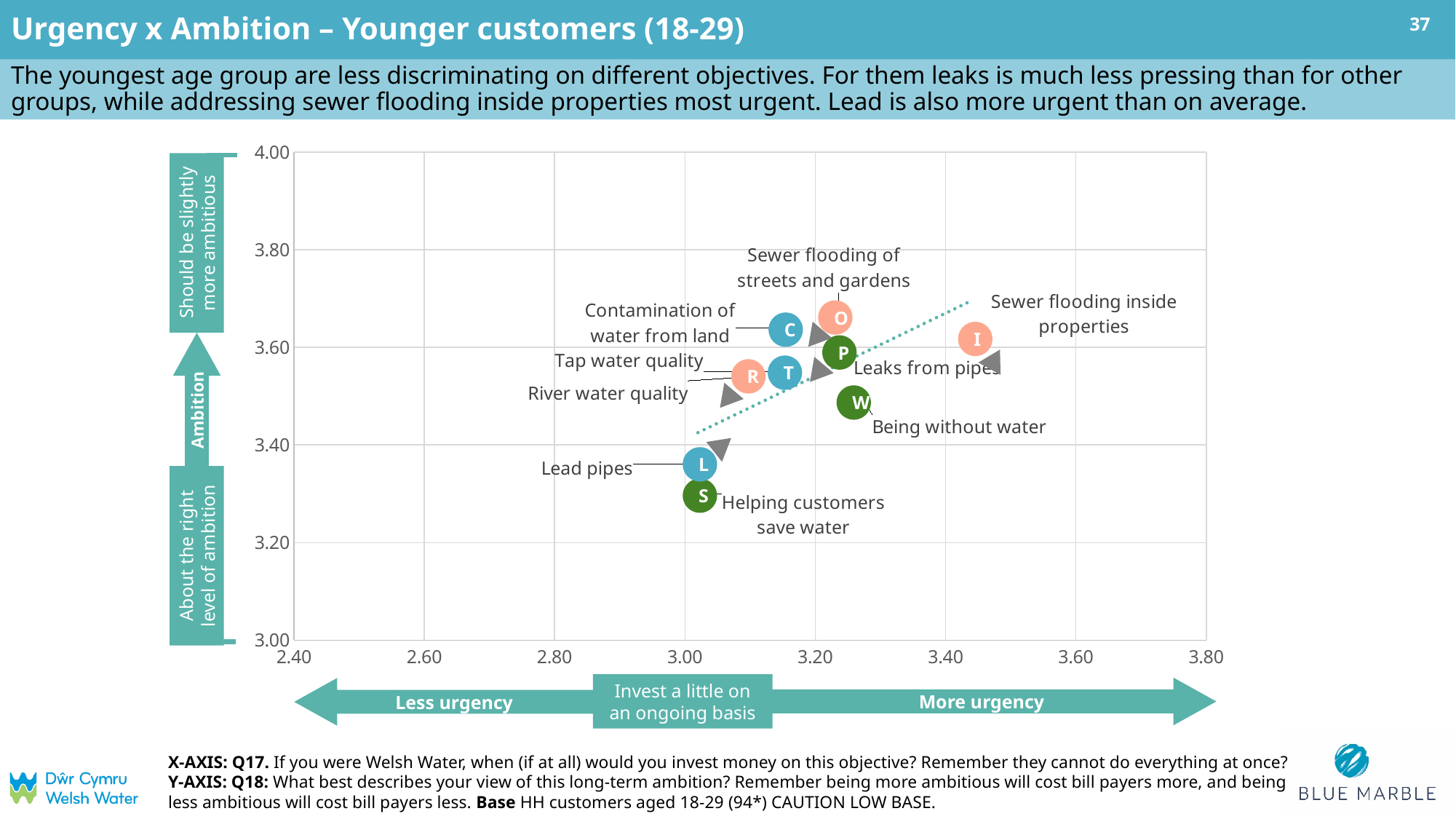
What is the title of the slide's chart? Urgency x Ambition – Younger customers (18-29) How many objectives are plotted as points on the chart? 9 Is the ambition (y-axis) value for Lead pipes greater or less than 3.40? less Is the urgency (x-axis) value for Helping customers save water greater or less than 3.20? less Which objective has the highest ambition score (highest on the y axis)? Sewer flooding of streets and gardens Is the ambition (y-axis) value for Being without water greater or less than 3.40? greater Which has the higher urgency (x-axis) value: Leaks from pipes or Lead pipes? Leaks from pipes Which objective has the highest urgency (furthest right on the x axis)? Sewer flooding inside properties What kind of chart is shown on the slide? Scatter chart Which has the higher ambition (y-axis) value: Contamination of water from land or Being without water? Contamination of water from land Which objective has the lowest ambition score (lowest on the y axis)? Helping customers save water